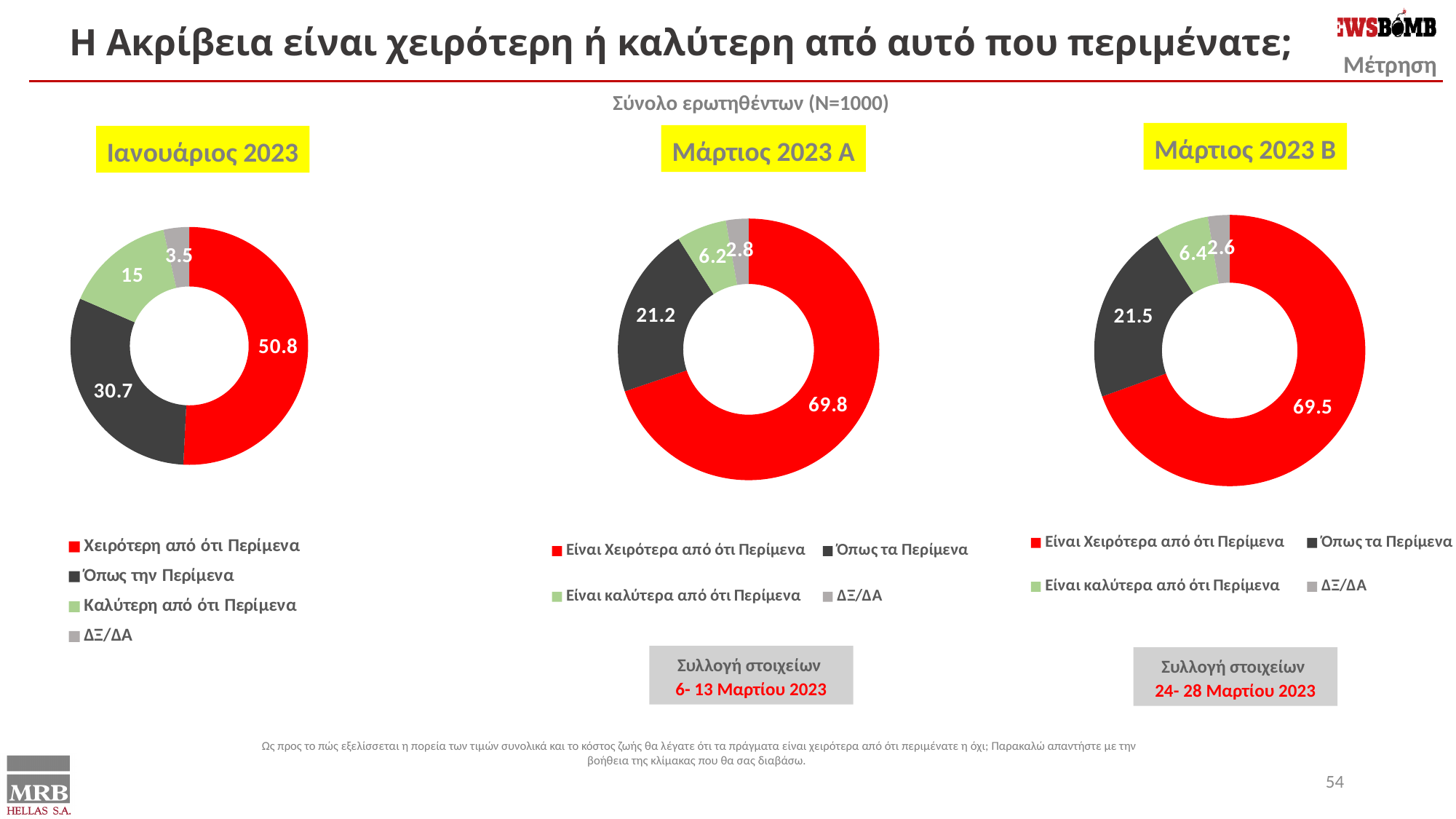
In the Μάρτιος 2023 Β chart, what is the value for Είναι καλύτερα από ότι Περίμενα? 6.4 In the Μάρτιος 2023 Α chart, which category has the largest value? Είναι Χειρότερα από ότι Περίμενα What is the difference between the Είναι Χειρότερα από ότι Περίμενα value in the Μάρτιος 2023 Α chart and the same category in the Μάρτιος 2023 Β chart? 0.3 Is the Είναι Χειρότερα από ότι Περίμενα value larger in the Μάρτιος 2023 Α chart or the Μάρτιος 2023 Β chart? Μάρτιος 2023 Α In the Μάρτιος 2023 Α chart, what is the value for Όπως τα Περίμενα? 21.2 In the Ιανουάριος 2023 chart, what is the difference between Χειρότερη από ότι Περίμενα and Όπως την Περίμενα? 20.1 What colour represents Όπως τα Περίμενα in the Μάρτιος 2023 Α chart? Dark grey How many categories does the Ιανουάριος 2023 chart show? 4 What kind of chart is the Μάρτιος 2023 Β chart? Pie (donut) chart In the Ιανουάριος 2023 chart, which category has the smallest value? ΔΞ/ΔΑ In the Ιανουάριος 2023 chart, what is the value for Χειρότερη από ότι Περίμενα? 50.8 In the Μάρτιος 2023 Β chart, what is the value for ΔΞ/ΔΑ? 2.6